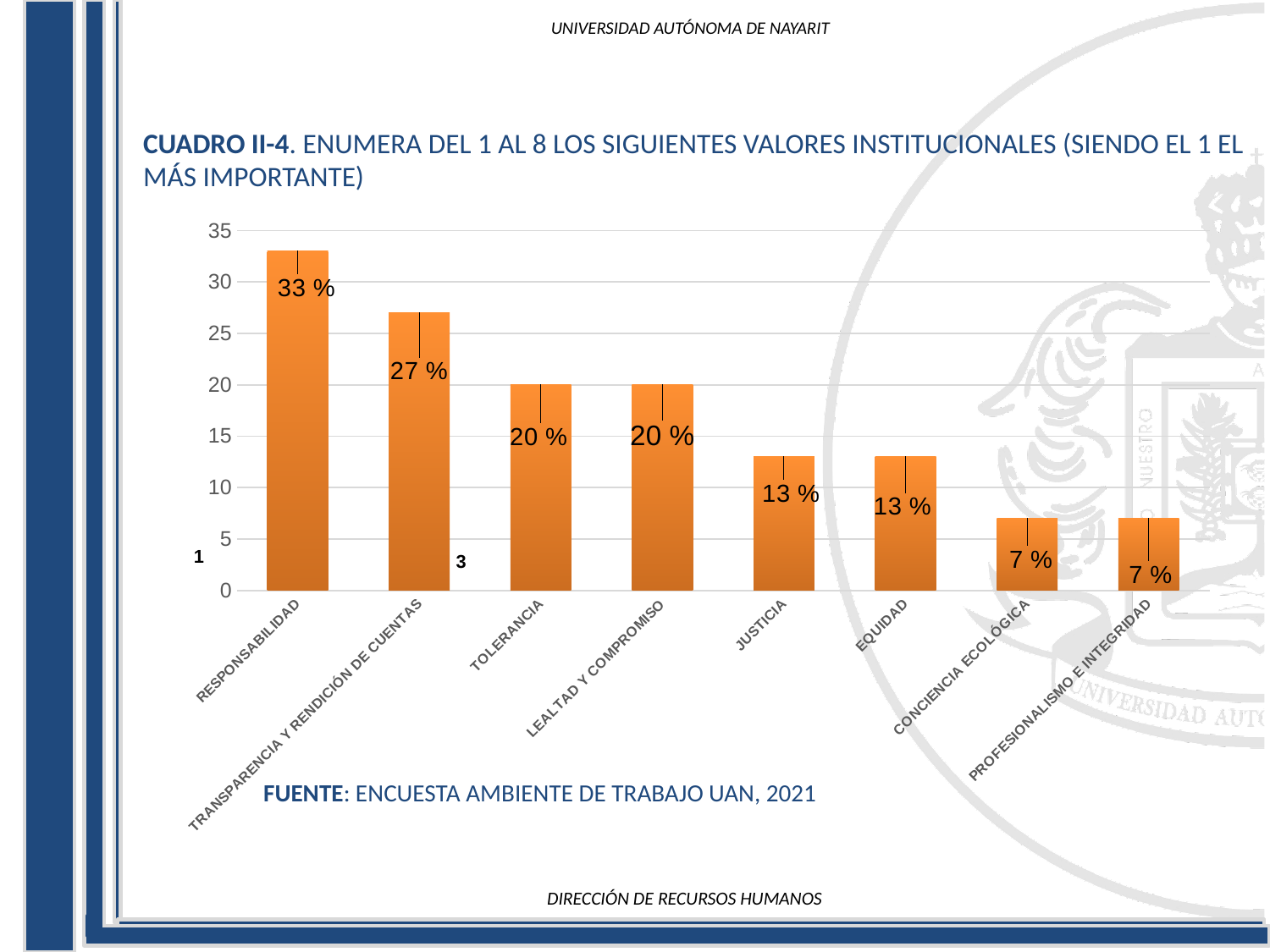
What is the value for TRANSPARENCIA Y RENDICIÓN DE CUENTAS? 27 % Is the value for LEALTAD Y COMPROMISO greater or less than 15? greater Which category has the highest value? RESPONSABILIDAD Do the values rise or fall from left to right along the x axis? fall What is the value for JUSTICIA? 13 % What is the value for CONCIENCIA ECOLÓGICA? 7 % Which is larger, the value for TOLERANCIA or the value for EQUIDAD? TOLERANCIA What kind of chart is shown on the slide? bar chart How many categories are plotted in the chart? 8 What is the difference between the values for RESPONSABILIDAD and TRANSPARENCIA Y RENDICIÓN DE CUENTAS? 6 % What is the value for RESPONSABILIDAD? 33 % What source is cited below the chart? ENCUESTA AMBIENTE DE TRABAJO UAN, 2021